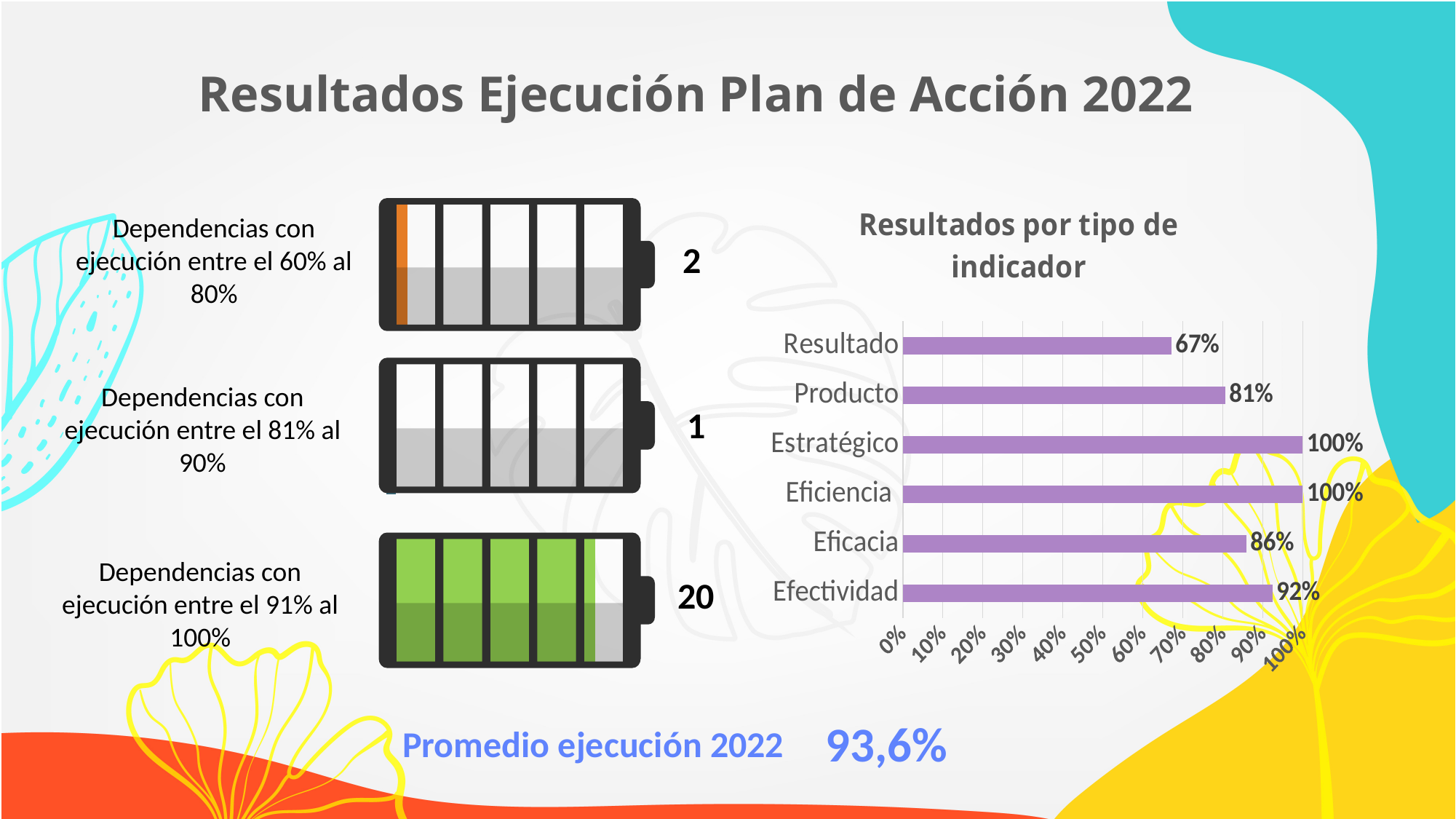
What is the value for Resultado in the 'Resultados por tipo de indicador' chart? 67% How many categories are shown in the 'Resultados por tipo de indicador' chart? 6 What is the title of the chart on the right side of the slide? Resultados por tipo de indicador Is the value for Resultado in the 'Resultados por tipo de indicador' chart greater or less than 70%? less What is the value for Efectividad in the 'Resultados por tipo de indicador' chart? 92% What kind of chart is 'Resultados por tipo de indicador'? Bar chart What is the value for Producto in the 'Resultados por tipo de indicador' chart? 81% What is the difference between the values for Efectividad and Resultado in the 'Resultados por tipo de indicador' chart? 25% Which categories reach 100% in the 'Resultados por tipo de indicador' chart? Estratégico and Eficiencia What is the value for Eficacia in the 'Resultados por tipo de indicador' chart? 86% Which category has the lowest value in the 'Resultados por tipo de indicador' chart? Resultado Which is larger in the 'Resultados por tipo de indicador' chart, Producto or Eficacia? Eficacia